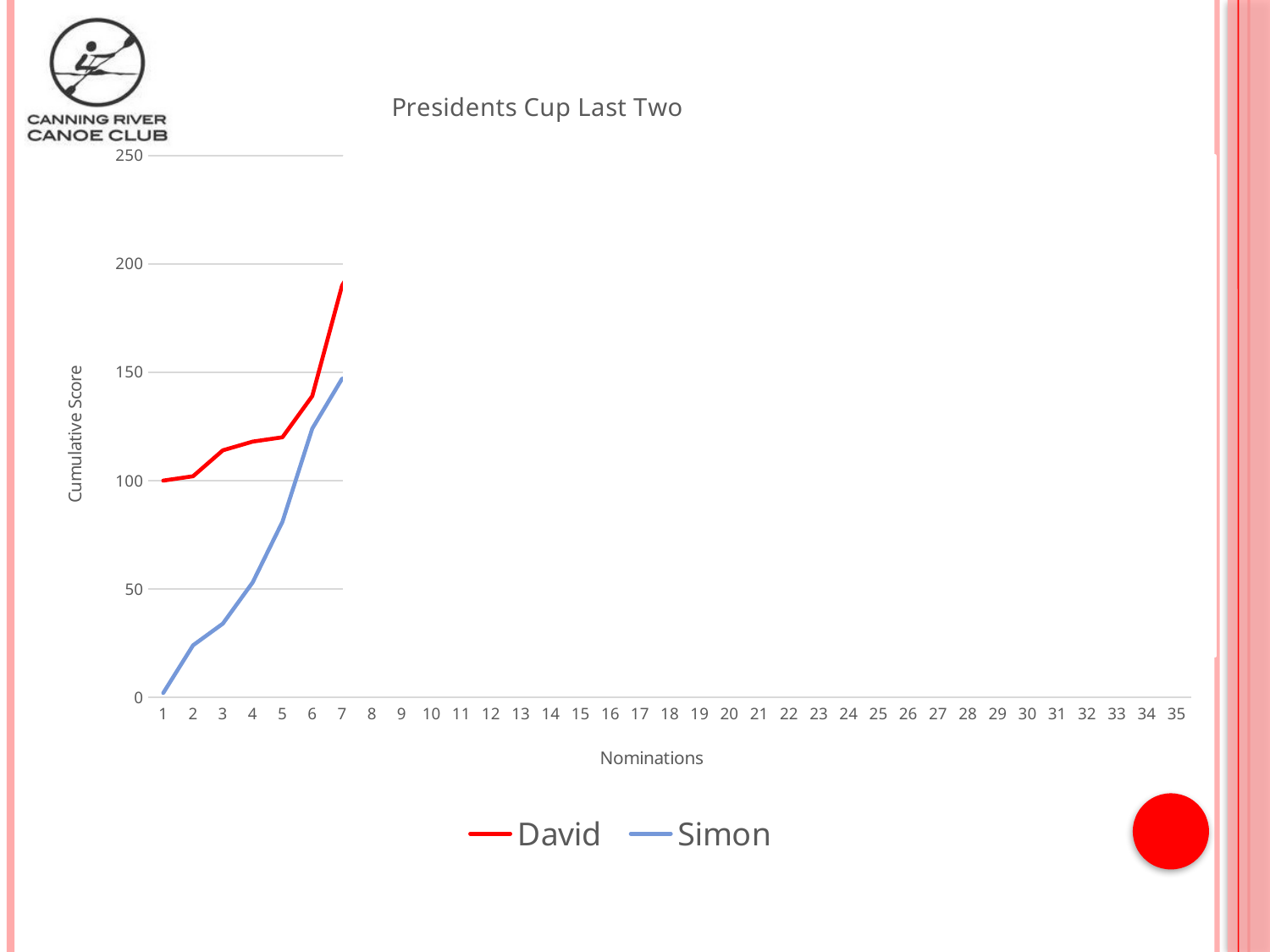
How many series does the legend list? 2 Is David's cumulative score at nomination 7 greater or less than 150? greater At nomination 3, who has the higher cumulative score, David or Simon? David What kind of chart is shown on the slide? line chart What is David's cumulative score at nomination 1? 100 What is the label on the vertical axis of the chart? Cumulative Score Is Simon's cumulative score at nomination 2 greater or less than 50? less Does Simon's cumulative score rise or fall from nomination 1 to nomination 7? rise What is the title of the chart? Presidents Cup Last Two Is Simon's cumulative score at nomination 6 greater or less than 100? greater Up to which nomination number do the plotted lines extend? 7 How many nominations are labelled along the x axis? 35